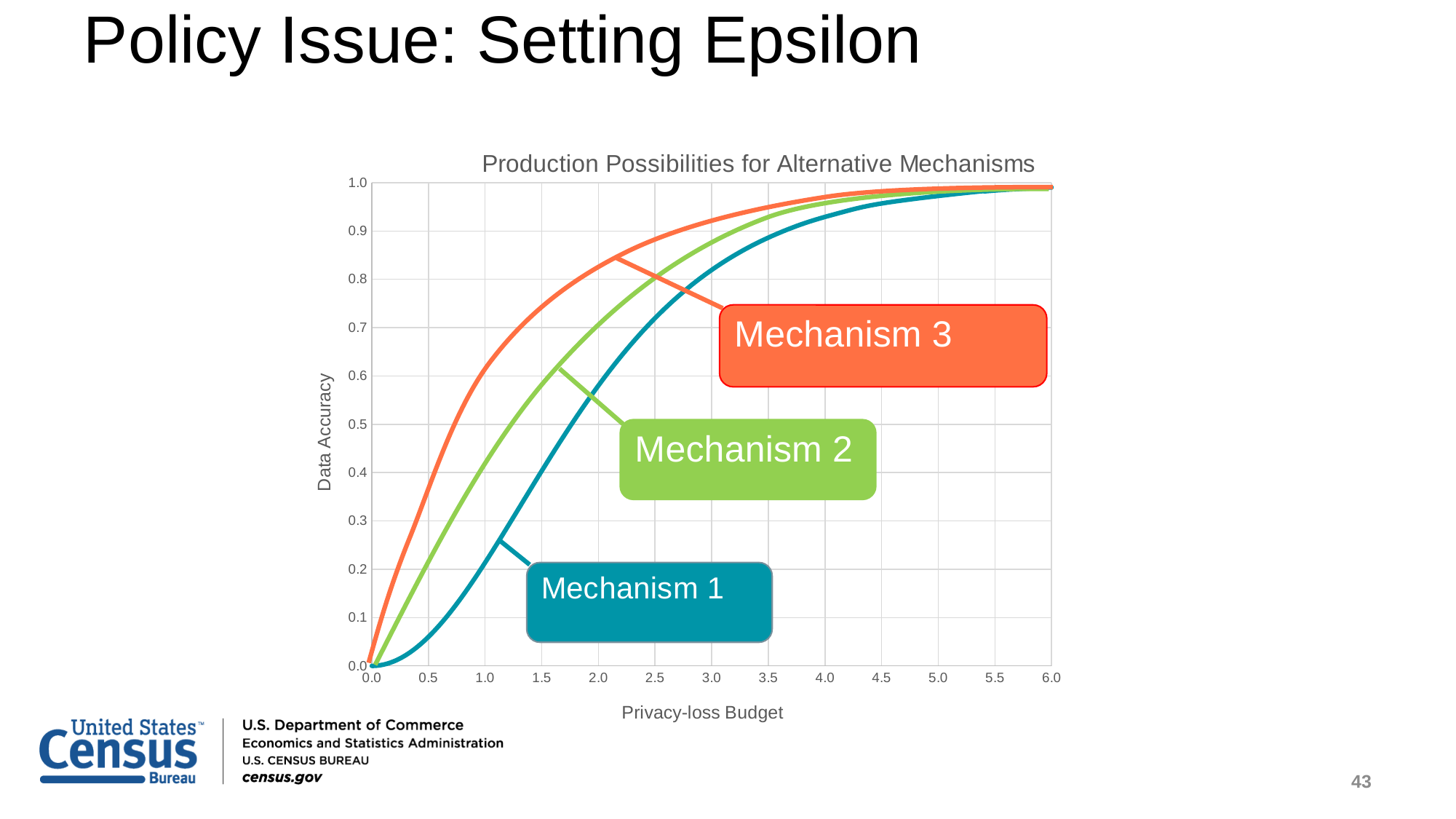
How many mechanisms (series) are plotted on the chart? 3 Which mechanism has the lowest Data Accuracy at a Privacy-loss Budget of 1.0? Mechanism 1 Is the Data Accuracy for Mechanism 1 at a Privacy-loss Budget of 1.0 greater or less than 0.3? less What kind of chart is shown on the slide? line chart What is the title of the chart? Production Possibilities for Alternative Mechanisms Do the Data Accuracy values for Mechanism 1 rise or fall as the Privacy-loss Budget increases? rise What is the Data Accuracy of Mechanism 3 at a Privacy-loss Budget of 0.0? 0.0 At a Privacy-loss Budget of 2.0, which has the higher Data Accuracy, Mechanism 2 or Mechanism 1? Mechanism 2 What is the label of the x axis? Privacy-loss Budget Which mechanism has the highest Data Accuracy at a Privacy-loss Budget of 1.0? Mechanism 3 Is the Data Accuracy for Mechanism 3 at a Privacy-loss Budget of 3.0 greater or less than 0.9? greater Is the Data Accuracy for Mechanism 3 at a Privacy-loss Budget of 1.0 greater or less than 0.5? greater